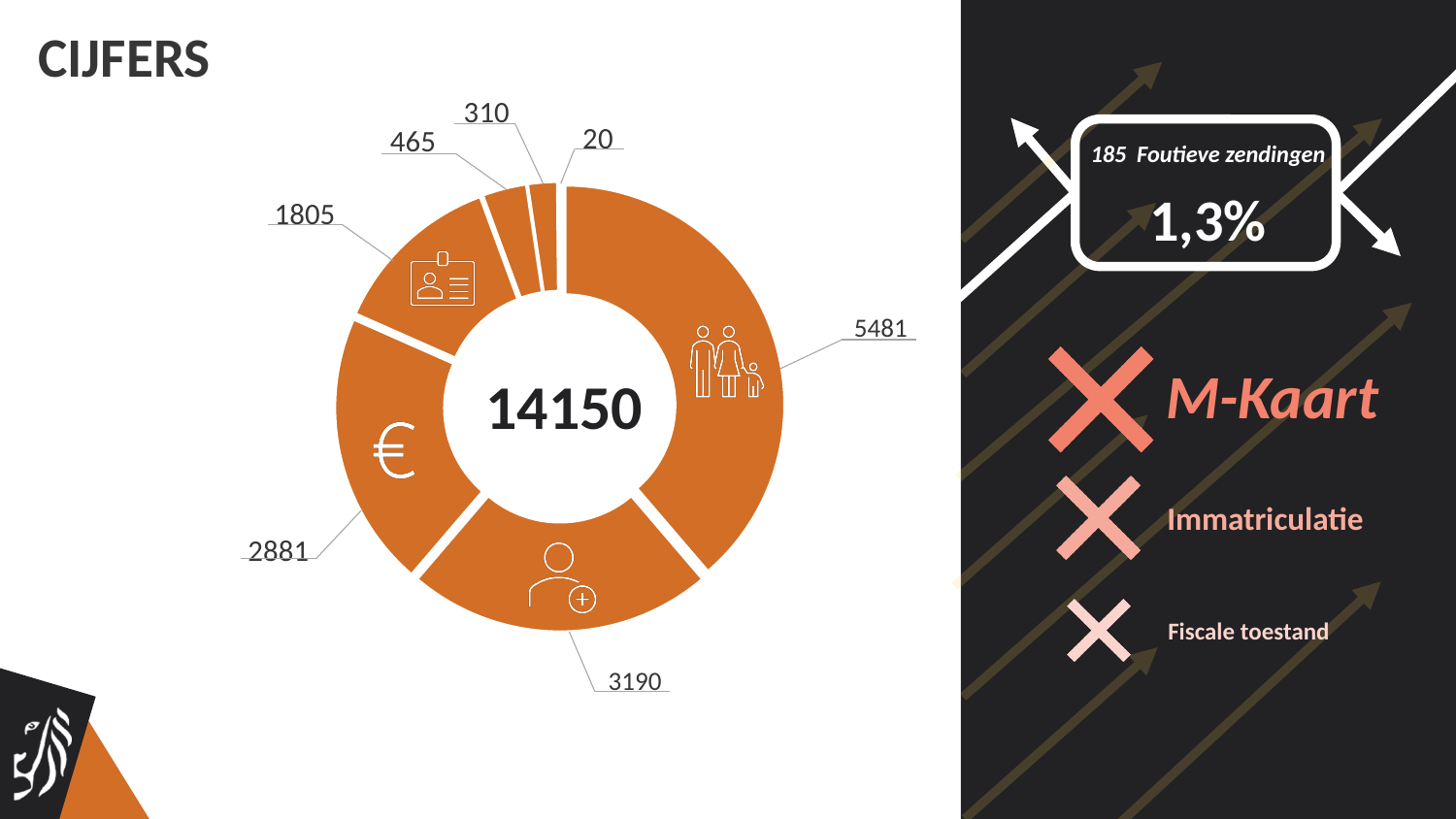
Which is larger: the slice labelled 465 or the slice labelled 310? 465 What is the value of the largest slice in the donut chart? 5481 What is the value of the smallest slice in the donut chart? 20 What is the difference between the slice labelled 5481 and the slice labelled 3190? 2291 How many slices does the donut chart have? 7 What is the value of the slice with the family icon? 5481 What is the value of the slice with the ID card icon? 1805 What is the value of the slice with the euro sign icon? 2881 What is the title of the slide containing the donut chart? CIJFERS What number is printed in the centre of the donut chart? 14150 What colour are the slices of the donut chart? Orange What kind of chart is shown on the slide? Donut (pie) chart